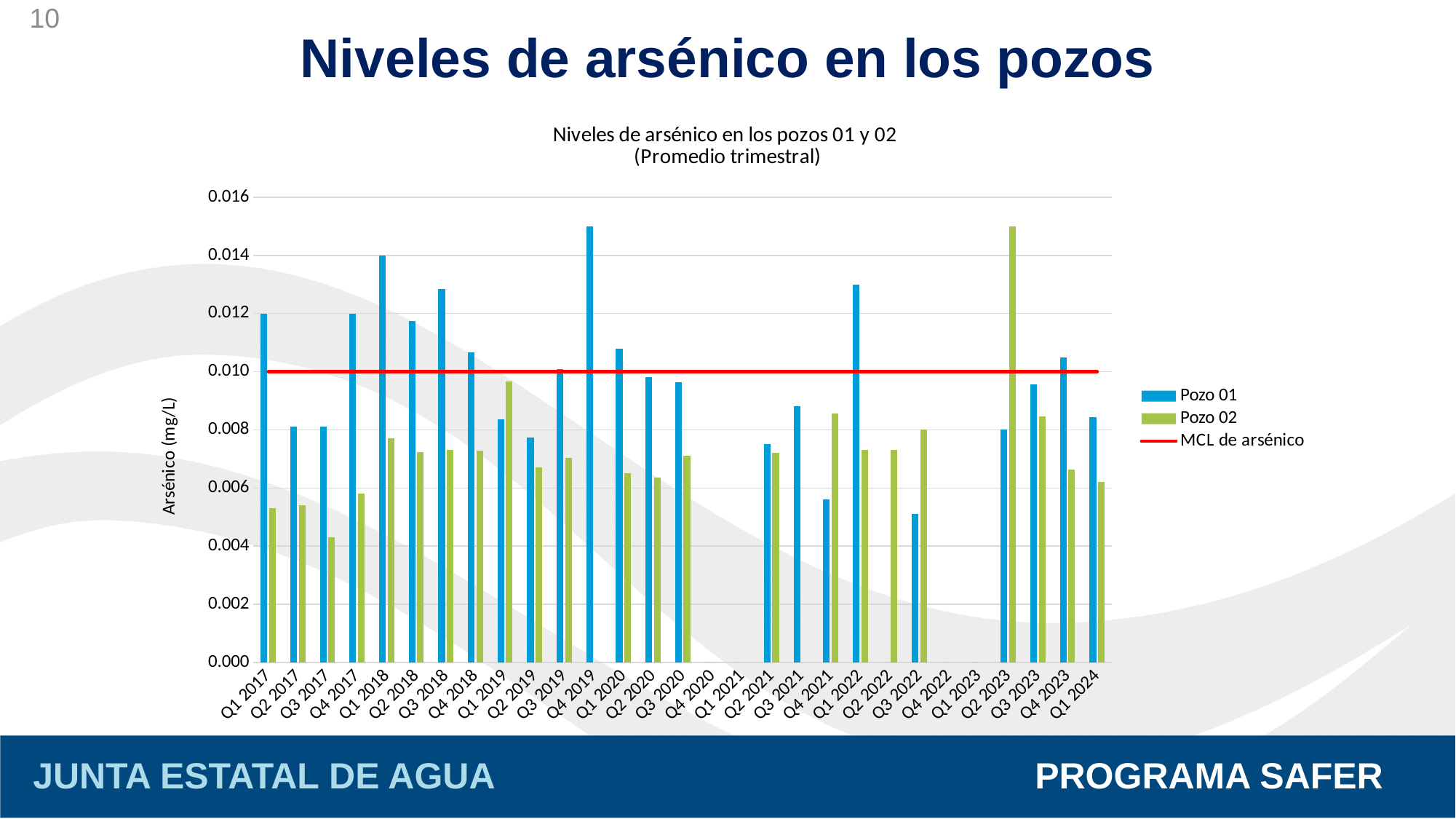
In which quarter does Pozo 02 reach its highest arsenic level? Q2 2023 What kind of chart is shown on the slide? combination bar and line chart Is the value for Pozo 02 in Q2 2019 greater or less than 0.008? less At what value on the y axis is the MCL de arsénico line drawn? 0.010 In Q4 2021, which well has the higher arsenic level, Pozo 01 or Pozo 02? Pozo 02 Is the value for Pozo 01 in Q1 2018 greater or less than 0.012? greater In which quarter does Pozo 01 reach its highest arsenic level? Q4 2019 Is the value for Pozo 01 in Q1 2022 greater or less than 0.012? greater How many entries does the chart legend list? 3 What is the label of the y axis? Arsénico (mg/L) How many quarterly categories are shown on the x axis? 29 In which quarter does Pozo 02 have its lowest arsenic level? Q3 2017